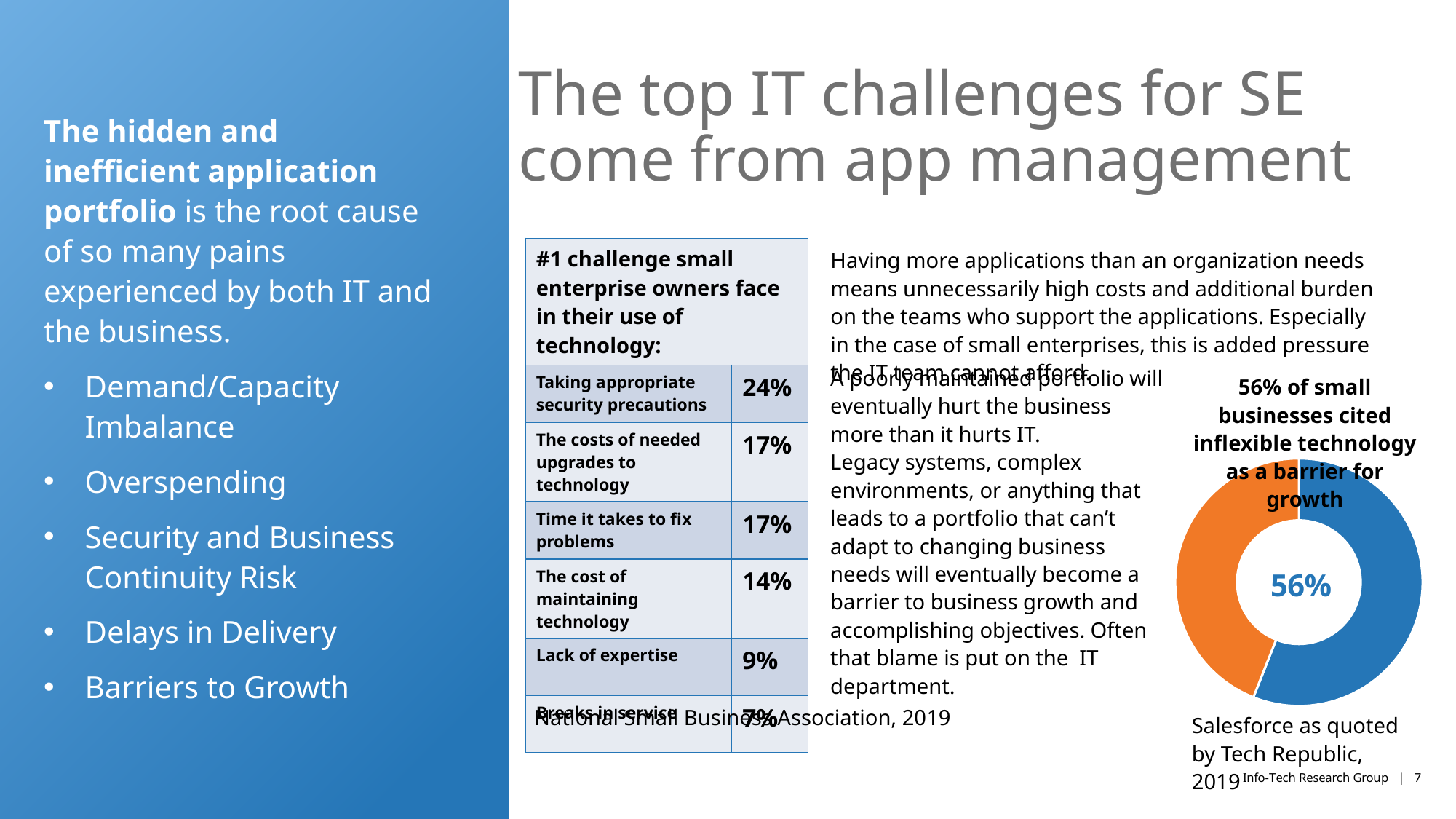
How many slices does the donut chart have? 2 What kind of chart is shown on the right side of the slide? Donut (pie) chart According to the donut chart, what share of small businesses cited inflexible technology as a barrier for growth? 56% What value is printed in the centre of the donut chart? 56% What is the title of the donut chart? 56% of small businesses cited inflexible technology as a barrier for growth Which slice of the donut chart is the smallest? The orange slice In the donut chart, which slice is larger, the blue one or the orange one? The blue one What colour is the slice of the donut chart that represents 56%? Blue